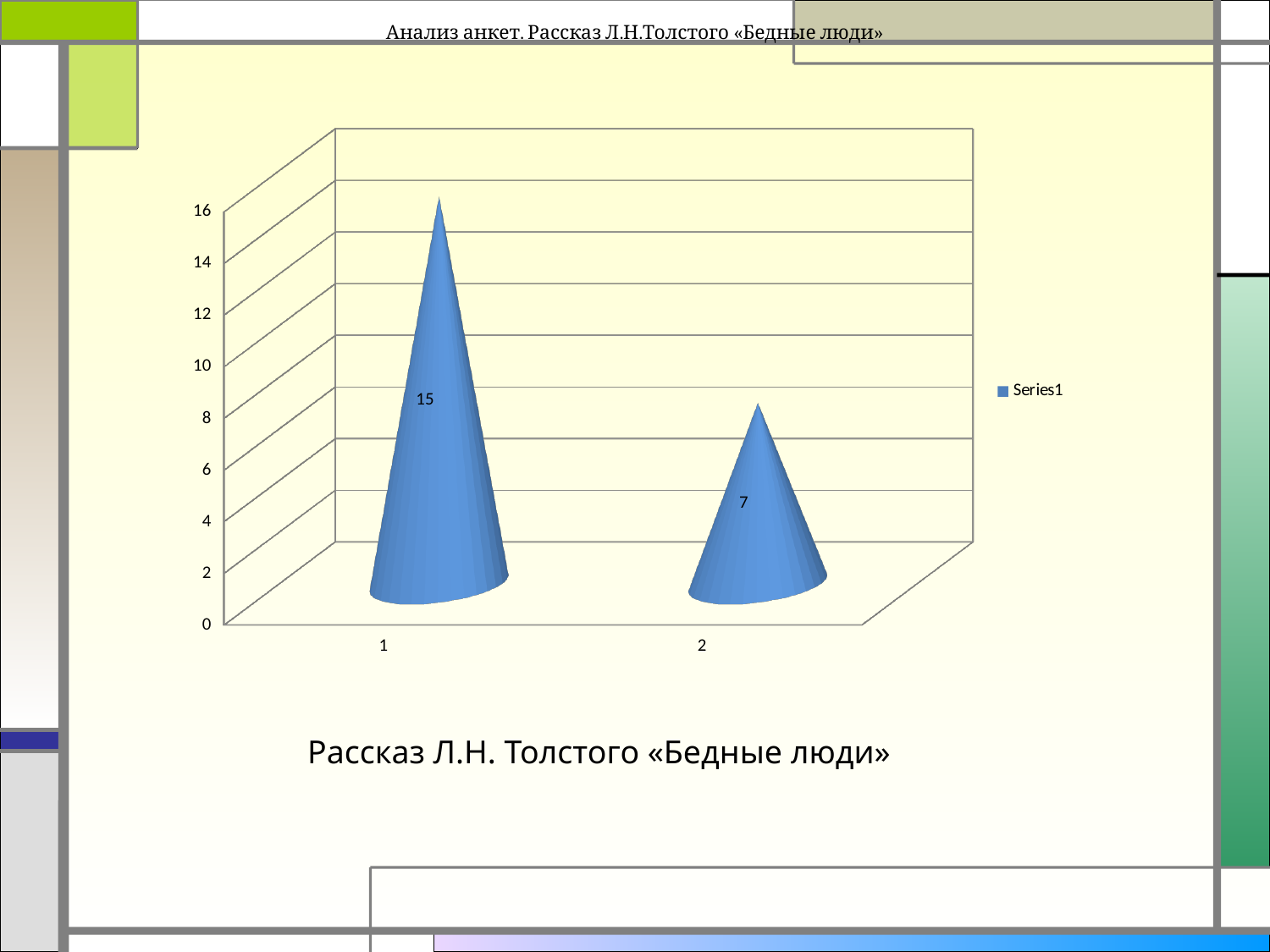
Do the values rise or fall from category 1 to category 2? fall Which category has the lowest value? 2 Is the value for category 2 greater or less than 10? less Which is larger, the value for category 1 or category 2? category 1 What is the value for category 1? 15 How many series does the legend list? 1 What is the name of the series in the legend? Series1 What kind of chart is shown on the slide? bar chart How many categories are shown on the x axis? 2 What is the difference between the values for category 1 and category 2? 8 Which category has the highest value? 1 What is the value for category 2? 7